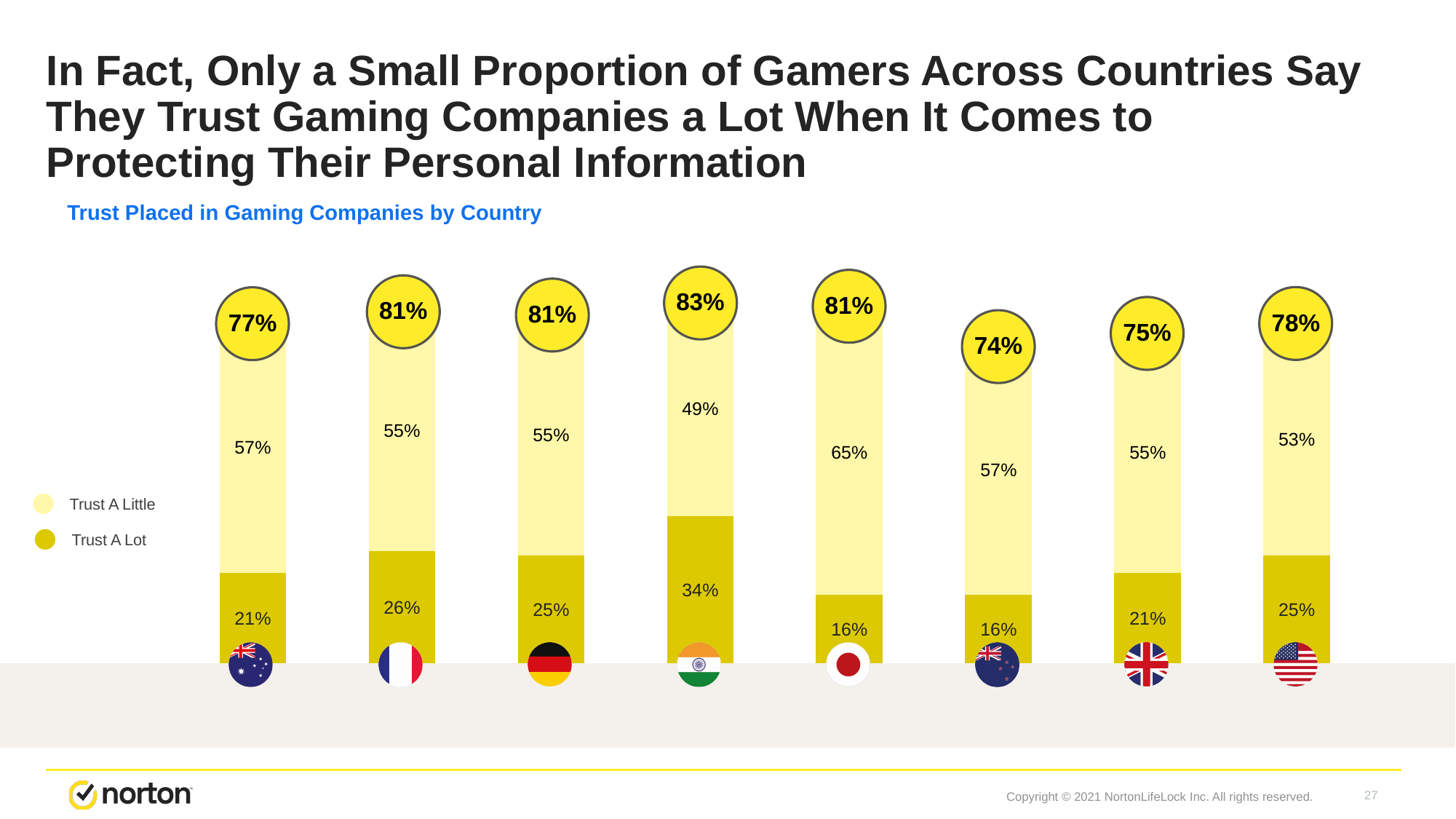
Which bar has the highest 'Trust A Lot' value, and what is it? The fourth bar (Indian flag), 34% Which bar has the highest total shown in the circle above it, and what is that total? The fourth bar (Indian flag), 83% Which has a larger 'Trust A Lot' value: the fourth bar (Indian flag) or the fifth bar (Japanese flag)? The fourth bar (Indian flag) What type of chart is shown on the slide? Stacked bar chart How many series does the legend list in the 'Trust Placed in Gaming Companies by Country' chart? 2 What is the total shown above the first bar from the left (Australian flag)? 77% What is the 'Trust A Little' value for the fifth bar from the left (Japanese flag)? 65% For the first bar from the left (Australian flag), what is the difference between the 'Trust A Little' and 'Trust A Lot' values? 36 percentage points What are the two legend entries in the chart? Trust A Little and Trust A Lot Which bar has the lowest total shown in the circle above it, and what is that total? The sixth bar (New Zealand flag), 74% How many country bars are shown in the chart? 8 What is the 'Trust A Lot' value for the fourth bar from the left (Indian flag)? 34%